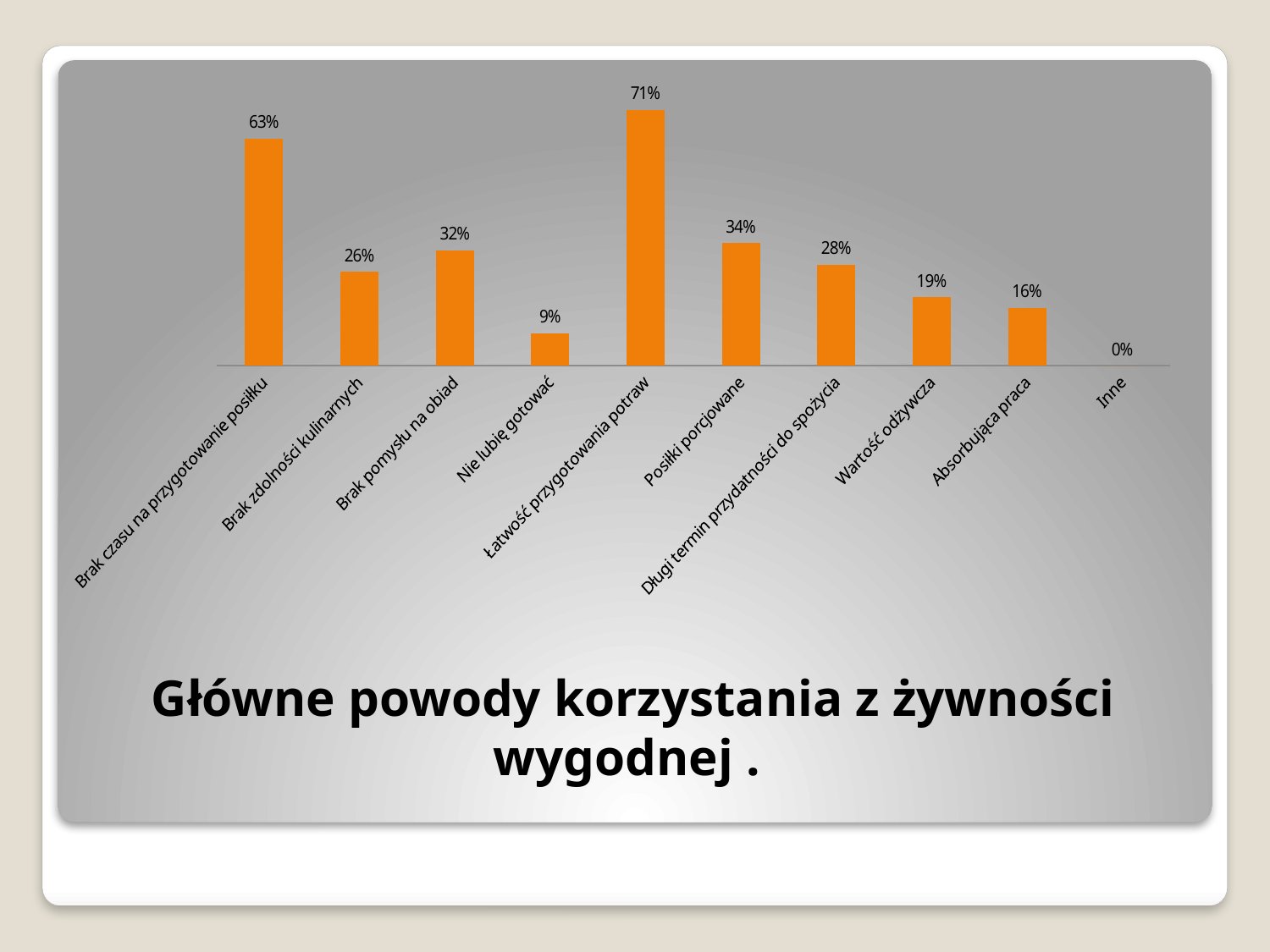
How many categories are shown on the chart? 10 What is the difference between the values for "Posiłki porcjowane" and "Długi termin przydatności do spożycia"? 6% What kind of chart is shown on the slide? Bar chart What is the title shown below the chart? Główne powody korzystania z żywności wygodnej . Which category has the lowest value? Inne What is the value for "Nie lubię gotować"? 9% What is the value for "Absorbująca praca"? 16% What is the difference between the values for "Łatwość przygotowania potraw" and "Brak czasu na przygotowanie posiłku"? 8% Which category has the highest value? Łatwość przygotowania potraw Which is larger, the value for "Brak pomysłu na obiad" or the value for "Brak zdolności kulinarnych"? Brak pomysłu na obiad What is the value for "Łatwość przygotowania potraw"? 71% What is the value for "Brak czasu na przygotowanie posiłku"? 63%